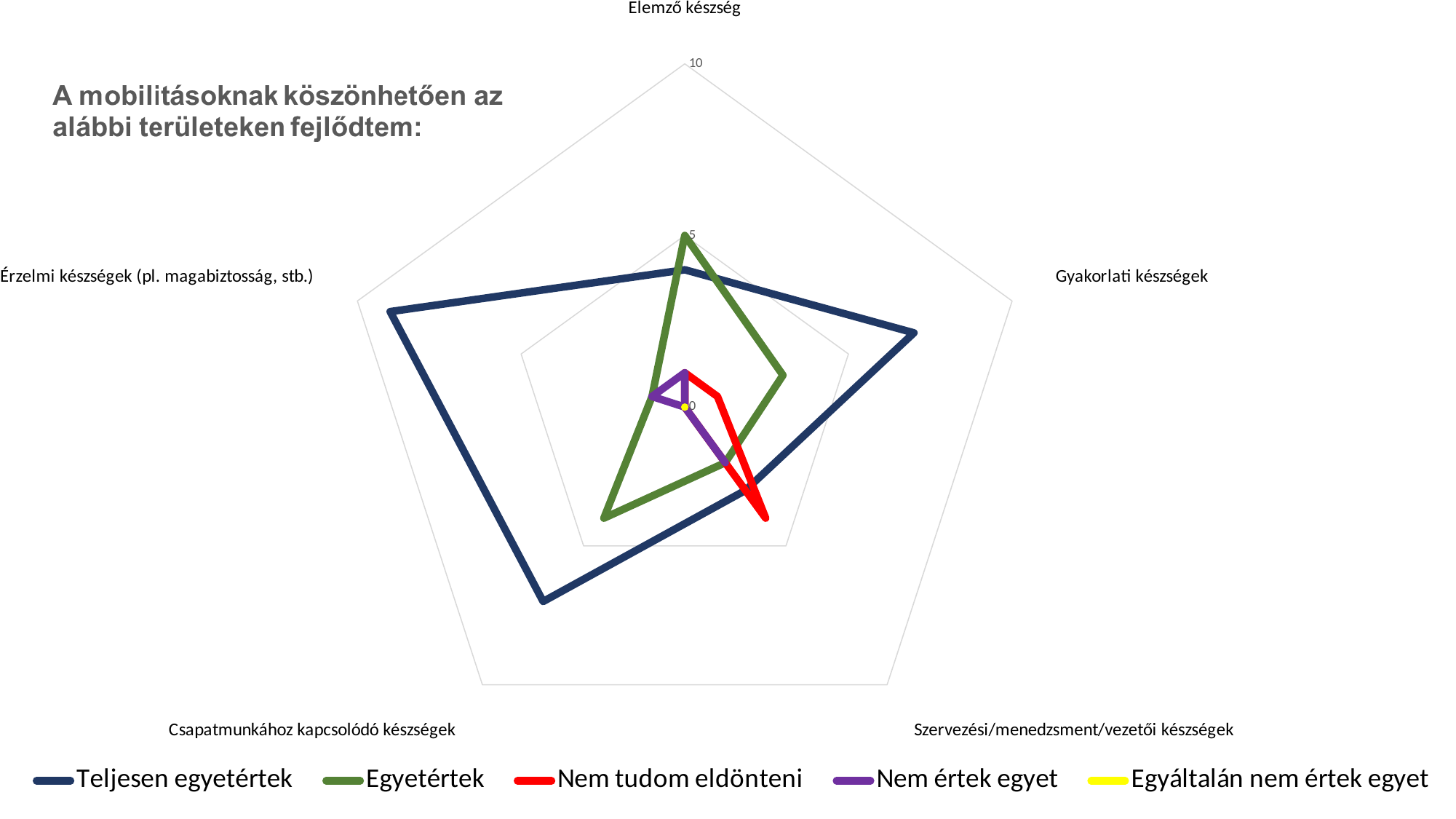
For 'Elemző készség', which series has the larger value: 'Egyetértek' or 'Teljesen egyetértek'? Egyetértek For 'Érzelmi készségek (pl. magabiztosság, stb.)', which series has the larger value: 'Teljesen egyetértek' or 'Egyetértek'? Teljesen egyetértek Is the value of 'Teljesen egyetértek' for 'Gyakorlati készségek' greater or less than 5? greater Is the value of 'Nem tudom eldönteni' for 'Szervezési/menedzsment/vezetői készségek' greater or less than 5? less Which series is drawn in red in the chart? Nem tudom eldönteni How many series does the legend list? 5 How many skill categories (axes) does the radar chart have? 5 Is the value of 'Egyetértek' for 'Gyakorlati készségek' greater or less than 5? less For which category does the 'Teljesen egyetértek' series reach its highest value? Érzelmi készségek (pl. magabiztosság, stb.) What kind of chart is shown on the slide? Radar chart What is the maximum value shown on the radar chart's axis scale? 10